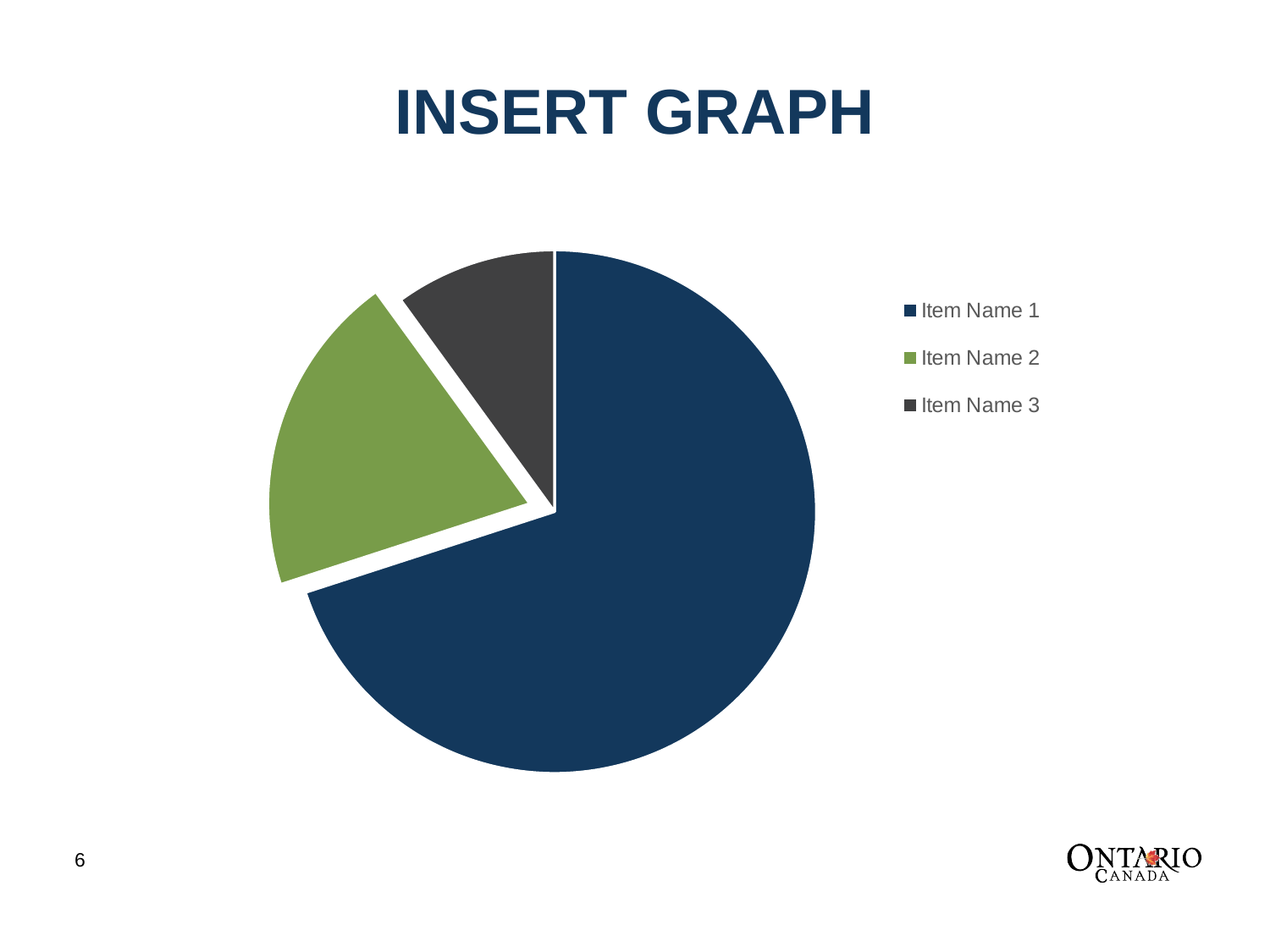
How many entries does the legend list? 3 What kind of chart is shown on the slide? pie chart Which item has the largest slice of the pie? Item Name 1 Which slice is larger, Item Name 2 or Item Name 3? Item Name 2 Which item has the smallest slice of the pie? Item Name 3 What colour is the slice for Item Name 2? green How many slices does the pie chart have? 3 What is the title shown above the chart? INSERT GRAPH Which slice is larger, Item Name 1 or Item Name 2? Item Name 1